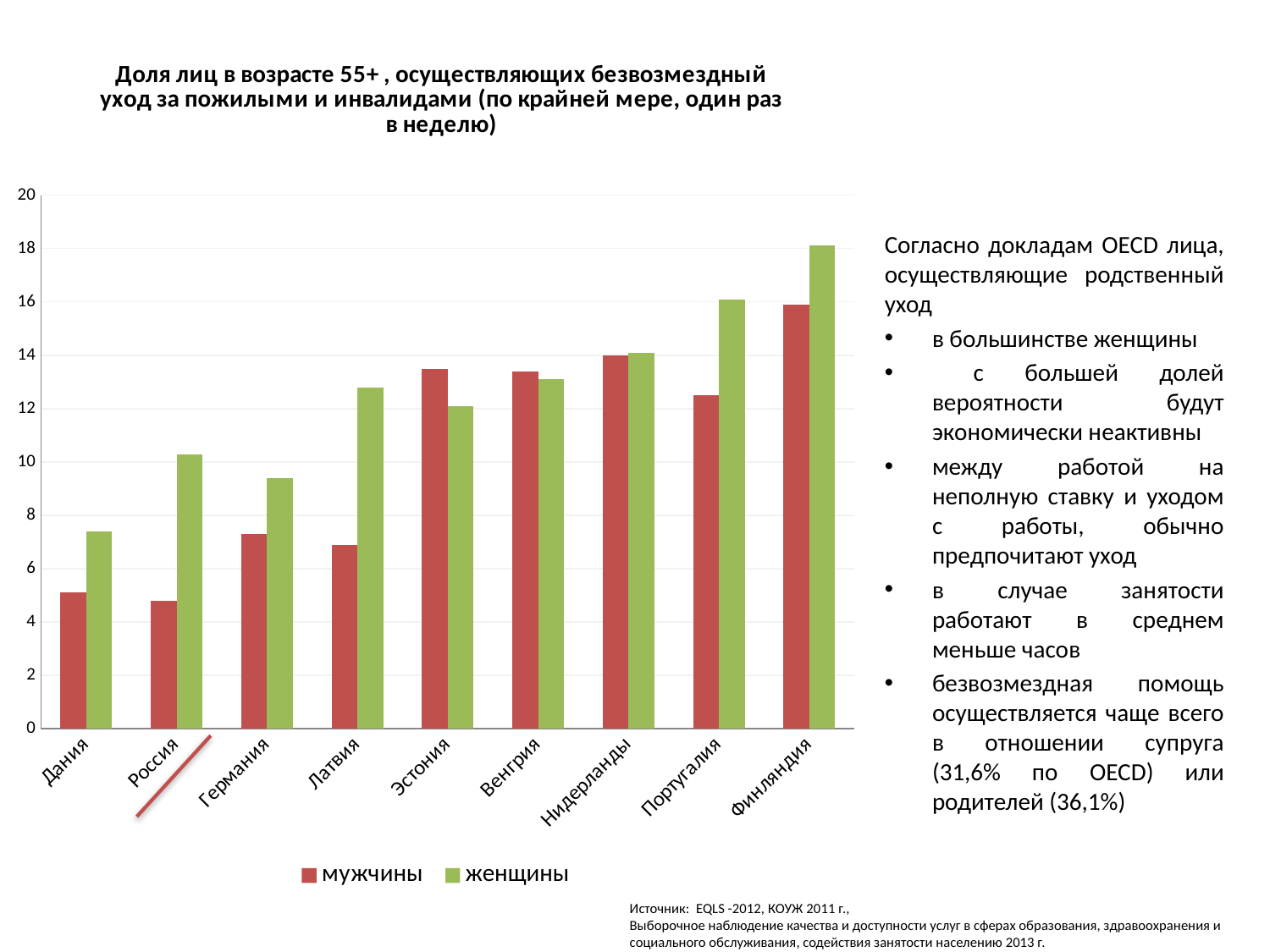
What kind of chart is shown on the slide? bar chart Which country has the lowest value for женщины? Дания How many series does the chart legend list? 2 In Эстония, which series has the larger value, мужчины or женщины? мужчины In Россия, which series has the larger value, мужчины or женщины? женщины Is the value for женщины in Финляндия greater or less than 16? greater What colour are the bars for the мужчины series? red How many countries are shown on the x axis of the chart? 9 Is the value for женщины in Латвия greater or less than 12? greater Is the value for мужчины in Португалия greater or less than 14? less Which country has the highest value for мужчины? Финляндия Which country has the highest value for женщины? Финляндия